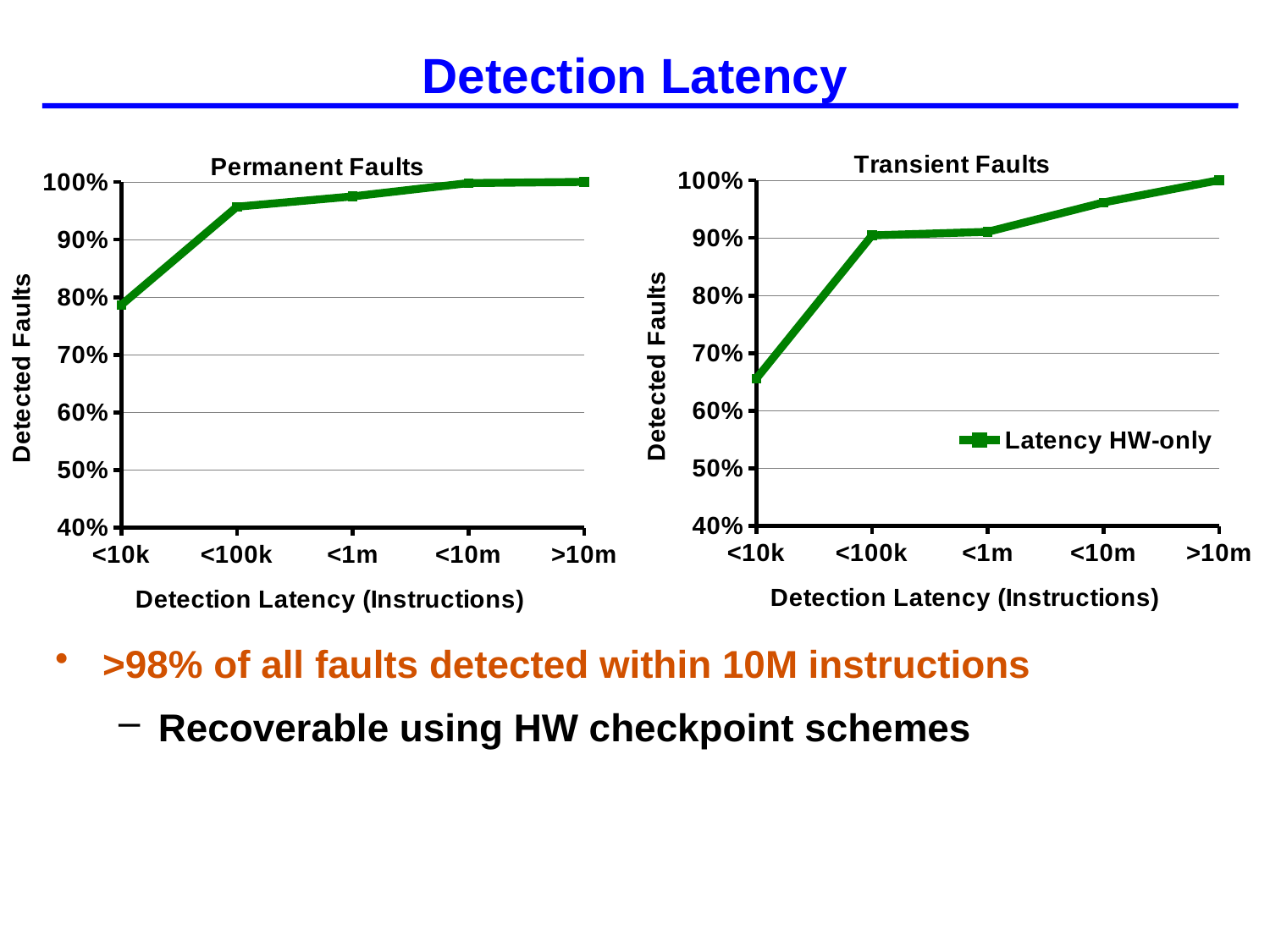
What series name does the legend on the Transient Faults chart show? Latency HW-only In the Transient Faults chart, is the value for <10k greater or less than 70%? less In the Permanent Faults chart, is the value for <100k greater or less than 90%? greater In the Transient Faults chart, is the value for <100k greater or less than 80%? greater What is the x-axis title of the Permanent Faults chart? Detection Latency (Instructions) Which detection latency category has the lowest value in the Permanent Faults chart? <10k Which is larger: the value for <10k in the Permanent Faults chart or the value for <10k in the Transient Faults chart? Permanent Faults What kind of chart is the Permanent Faults chart? line chart Do the values in the Transient Faults chart rise or fall as detection latency increases along the x axis? rise How many points are plotted along the x axis of the Transient Faults chart? 5